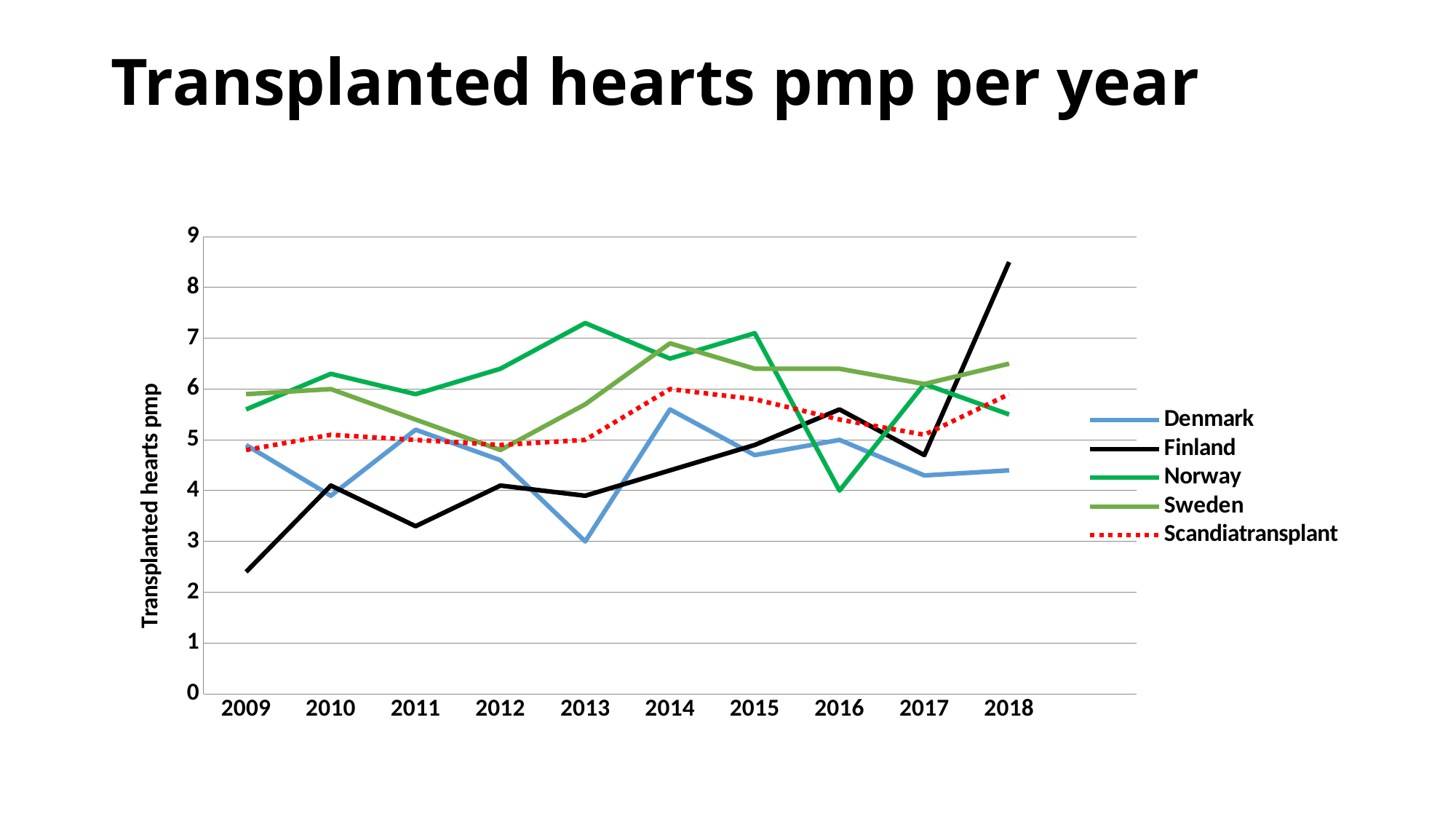
How many series does the legend list? 5 Is the value for Finland in 2009 greater or less than 3? less Is the value for Finland in 2018 greater or less than 8? greater Which series is drawn with a dotted line? Scandiatransplant Which series has the highest value in 2018? Finland Which series has the lowest value in 2013? Denmark Which series has the highest value in 2013? Norway Which series has the lowest value in 2009? Finland What kind of chart is shown on the slide? Line chart Which is larger in 2011, the value for Denmark or the value for Finland? Denmark How many years are shown on the x axis? 10 Does the value for Finland rise or fall from 2017 to 2018? Rise